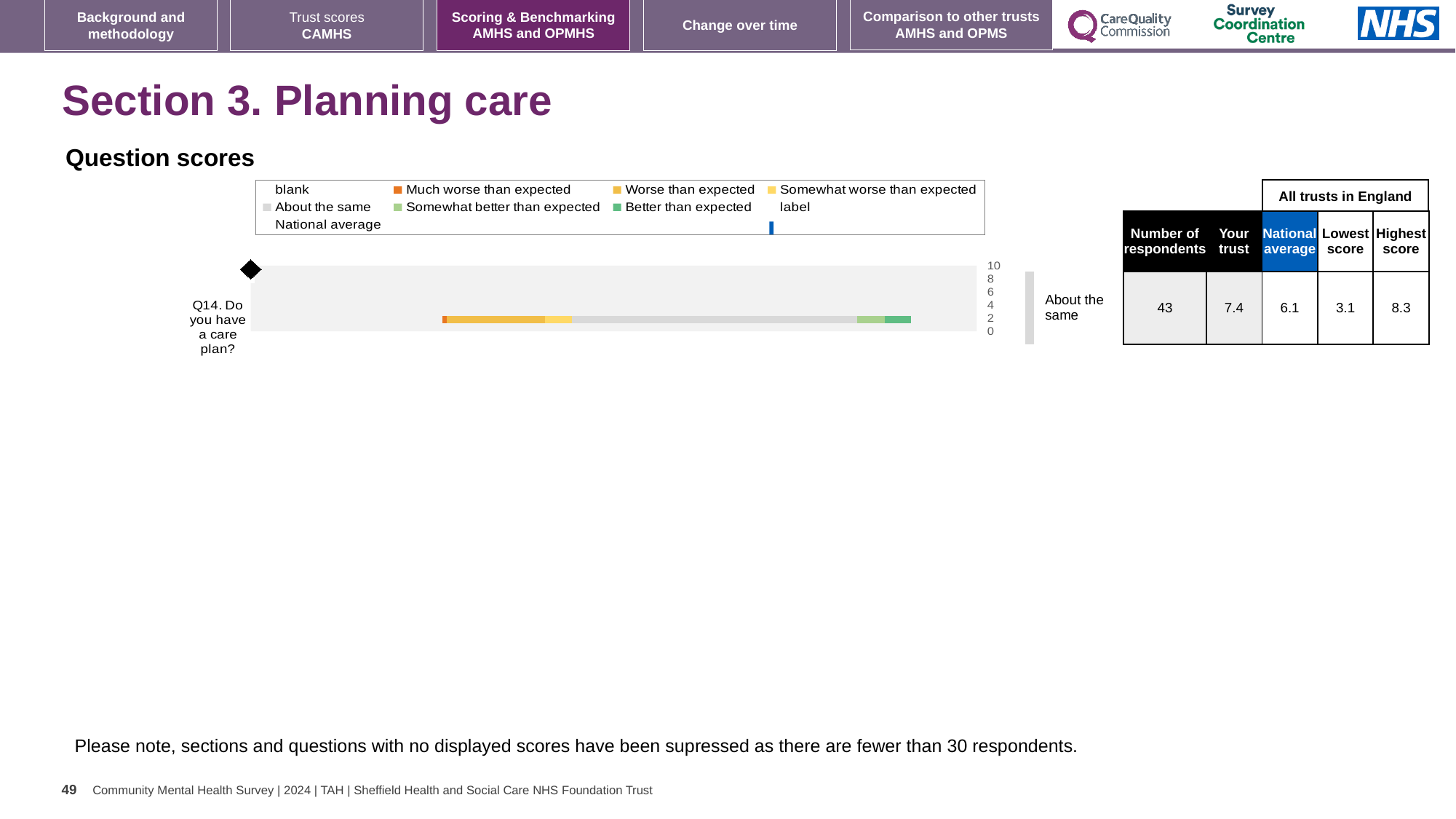
How many respondents answered Q14 'Do you have a care plan?' 43 What is the difference between the highest and lowest scores for Q14 across all trusts in England? 5.2 What is the highest score among all trusts in England for Q14? 8.3 Which is larger for Q14: the trust's score or the national average? Your trust What kind of chart is used to show the Q14 question score? bar chart What is the lowest score among all trusts in England for Q14? 3.1 What colour does the legend use for 'Much worse than expected'? Orange By how much does the trust's score for Q14 exceed the national average? 1.3 Which benchmark category is shown next to the Q14 bar? About the same What is the national average score for Q14 'Do you have a care plan?' 6.1 What is the 'Your trust' score for Q14 'Do you have a care plan?' 7.4 How many questions are plotted in the Question scores chart? 1